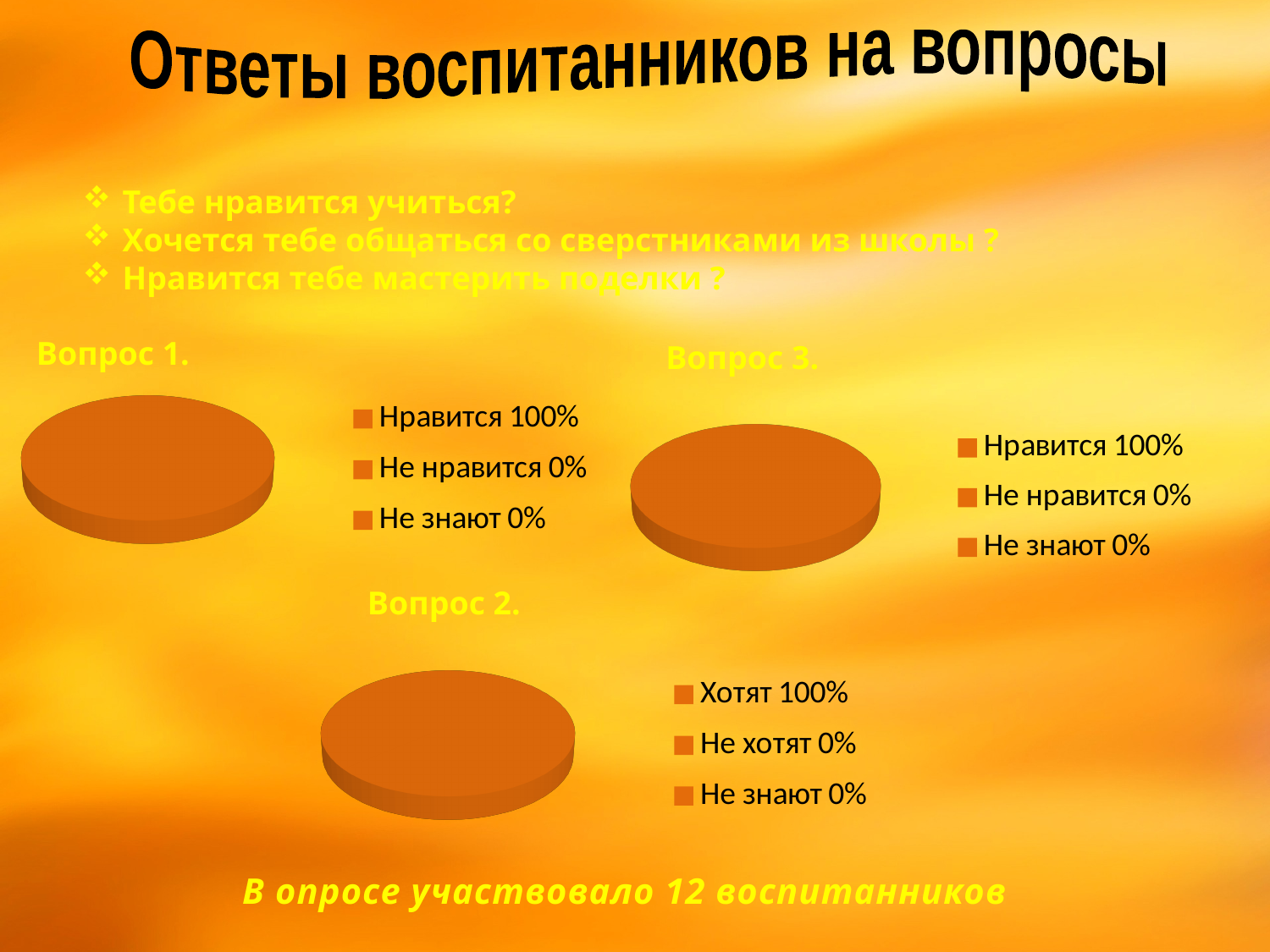
In the Вопрос 3 chart, which is larger: Нравится or Не нравится? Нравится In the Вопрос 1 chart, what is the difference between the shares for Нравится and Не знают? 100% In the Вопрос 3 chart, what share is shown for Не знают? 0% How many categories does the legend of the Вопрос 1 chart list? 3 In the Вопрос 1 chart, what share is shown for Нравится? 100% In the Вопрос 2 chart, what share is shown for Хотят? 100% What kind of chart is used for Вопрос 1? pie chart In the Вопрос 2 chart, what share is shown for Не хотят? 0% How many pie charts are shown on the slide? 3 In the Вопрос 2 chart, which category has the largest share? Хотят In the Вопрос 3 chart, which category has the largest share? Нравится In the Вопрос 1 chart, what share is shown for Не нравится? 0%